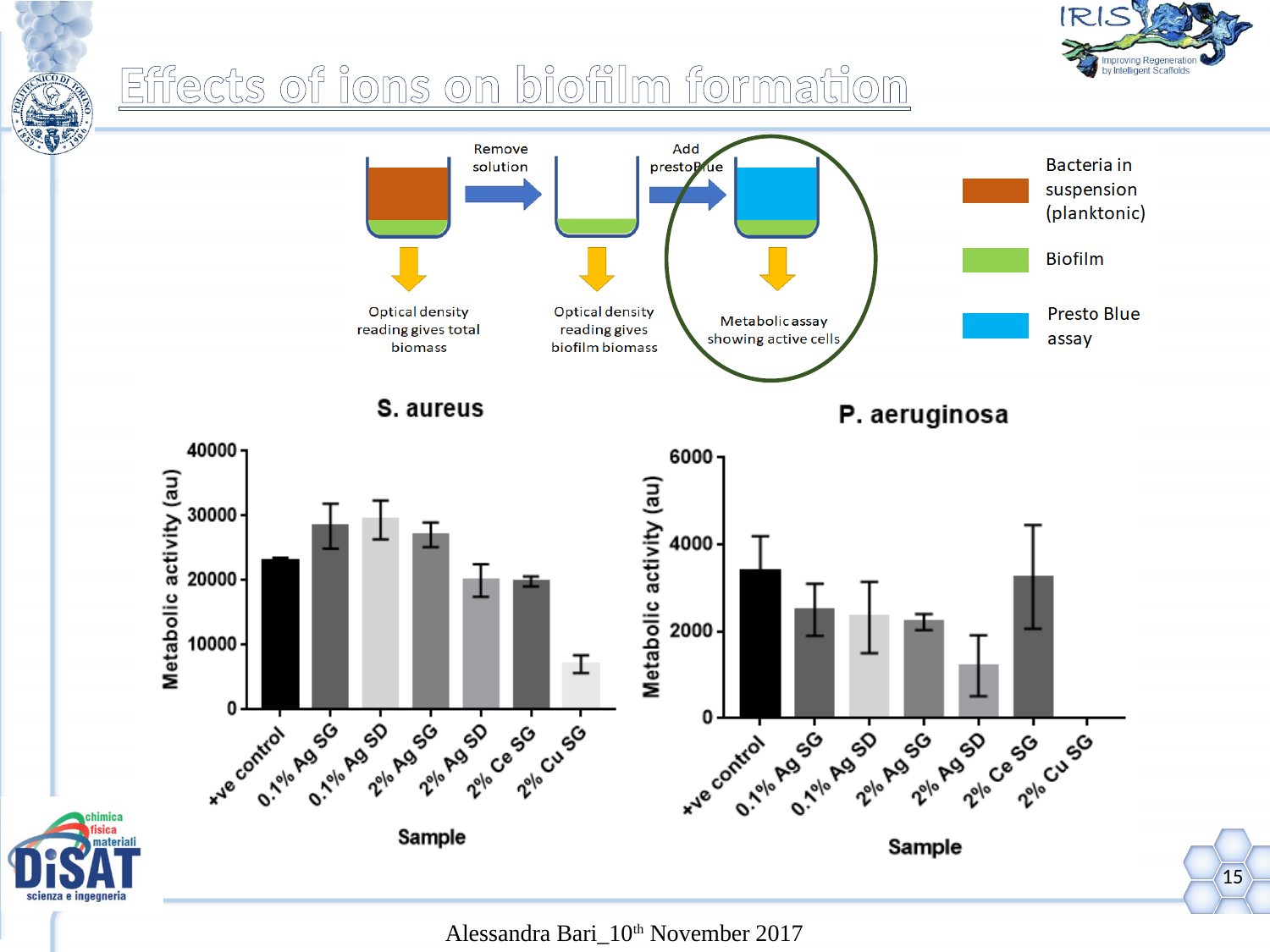
In the S. aureus chart, is the value for +ve control greater or less than 20000? greater In the S. aureus chart, which sample has the lowest metabolic activity? 2% Cu SG In the S. aureus chart, which is larger, the value for 0.1% Ag SG or the value for 2% Ag SD? 0.1% Ag SG In the P. aeruginosa chart, which sample has the lowest metabolic activity? 2% Cu SG In the P. aeruginosa chart, is the value for 2% Ag SD greater or less than 2000? less In the P. aeruginosa chart, is the value for +ve control greater or less than 2000? greater What is the x-axis title of the P. aeruginosa chart? Sample How many samples are shown on the x axis of the P. aeruginosa chart? 7 In the P. aeruginosa chart, which is larger, the value for 2% Ce SG or the value for 2% Ag SD? 2% Ce SG What kind of chart is the S. aureus chart? bar chart What is the y-axis title of the S. aureus chart? Metabolic activity (au)